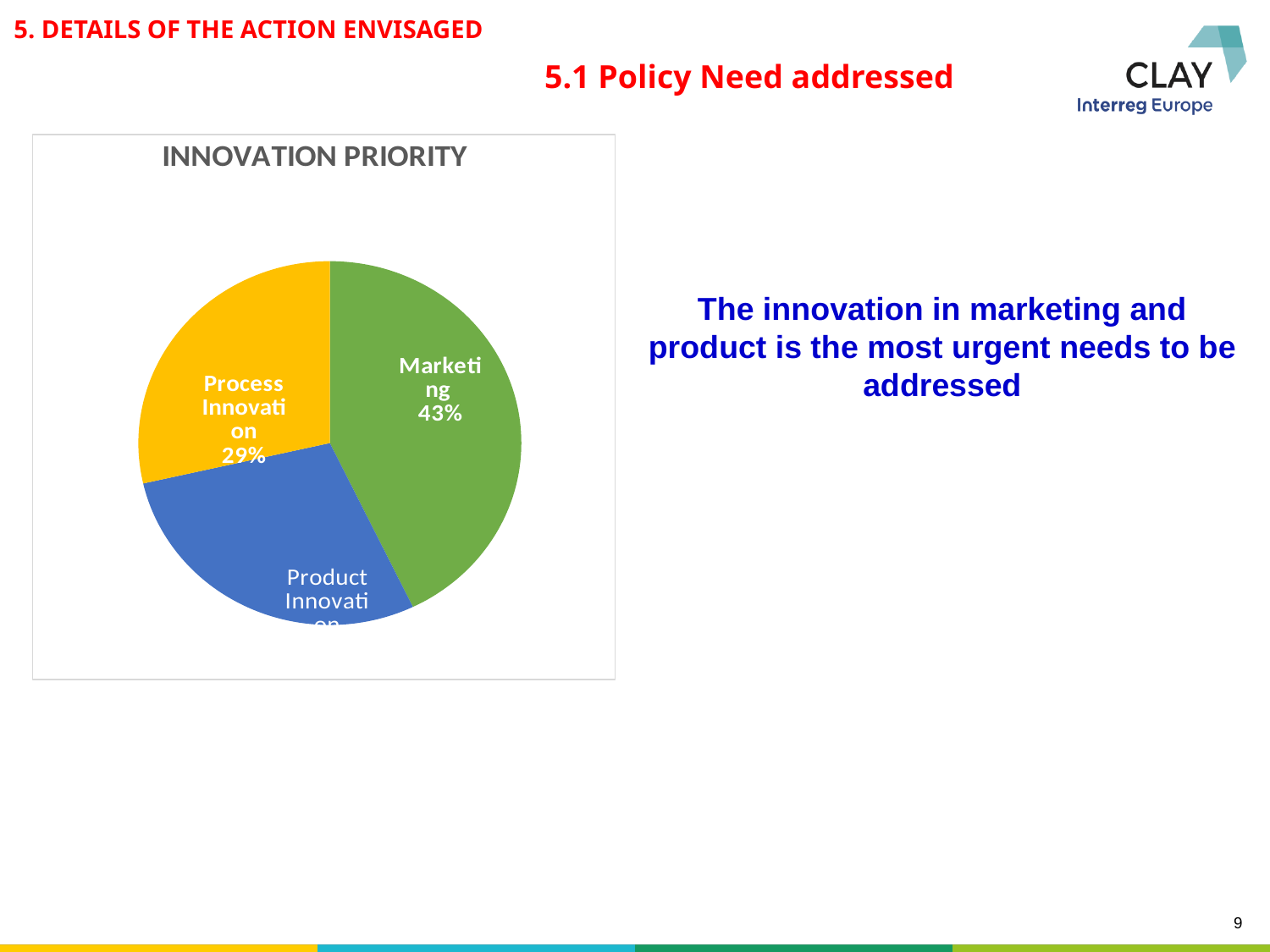
What is the title of the chart? INNOVATION PRIORITY What colour is the Marketing slice? Green What share of the pie does Process Innovation represent? 29% How many slices does the pie chart have? 3 What is the difference in percentage points between the Marketing share and the Process Innovation share? 14 percentage points Which is larger, the share for Marketing or the share for Process Innovation? Marketing What type of chart is shown on the slide? Pie chart What share of the pie does Marketing represent? 43% Which category is shown in the blue slice? Product Innovation Which category has the largest slice of the pie? Marketing